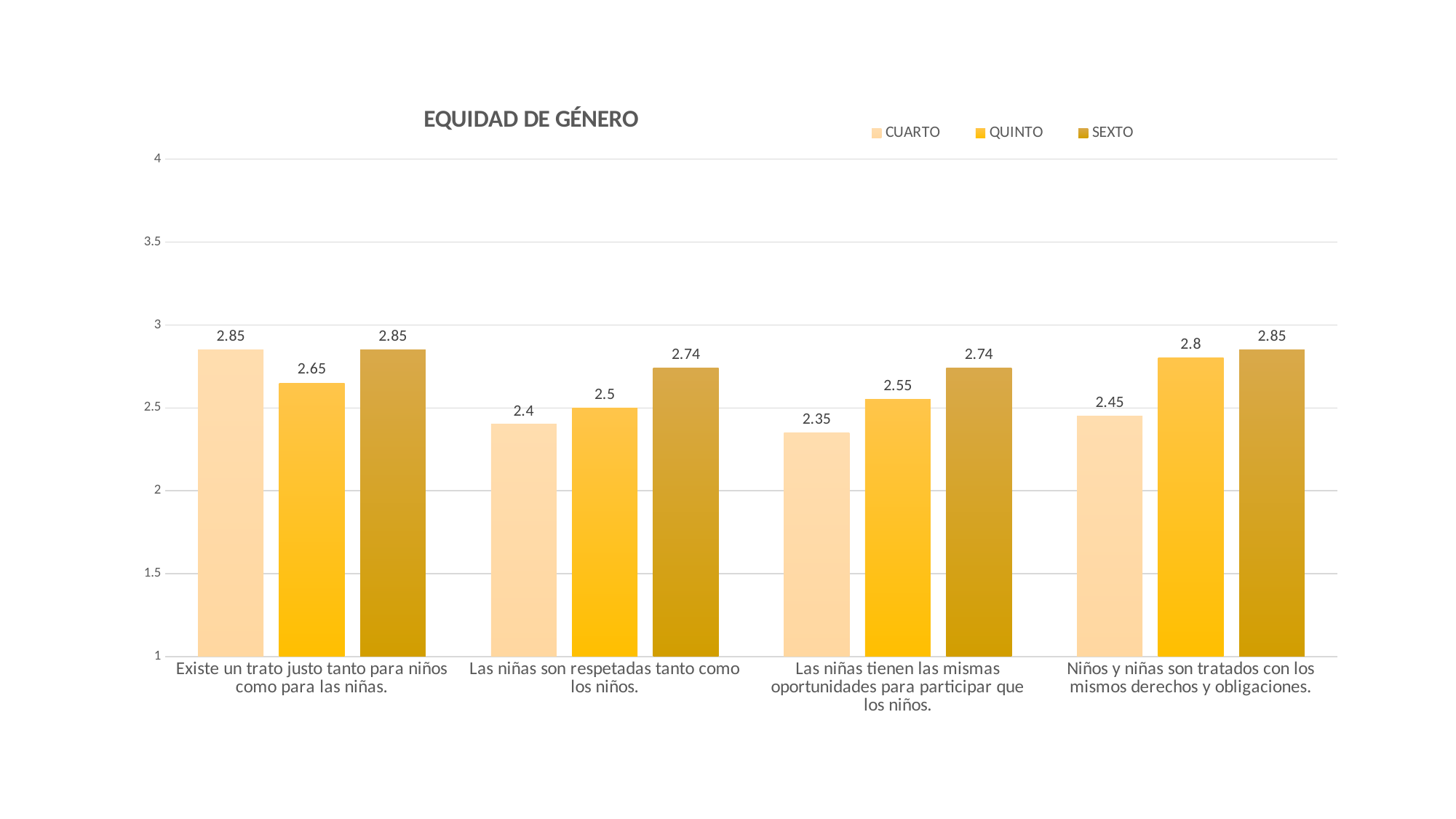
What is the value for CUARTO in the category "Existe un trato justo tanto para niños como para las niñas."? 2.85 What is the value for QUINTO in the category "Niños y niñas son tratados con los mismos derechos y obligaciones."? 2.8 In the category "Las niñas son respetadas tanto como los niños.", which is larger, CUARTO or QUINTO? QUINTO What is the value for SEXTO in the category "Las niñas son respetadas tanto como los niños."? 2.74 What is the difference between the CUARTO and QUINTO values in the category "Existe un trato justo tanto para niños como para las niñas."? 0.2 Which category has the lowest value for CUARTO? Las niñas tienen las mismas oportunidades para participar que los niños. What kind of chart is shown on the slide? Bar chart How many series does the legend list? 3 Which category has the lowest value for QUINTO? Las niñas son respetadas tanto como los niños. What is the difference between the SEXTO and CUARTO values in the category "Las niñas tienen las mismas oportunidades para participar que los niños."? 0.39 What is the title of the chart? EQUIDAD DE GÉNERO How many categories are shown on the x axis? 4